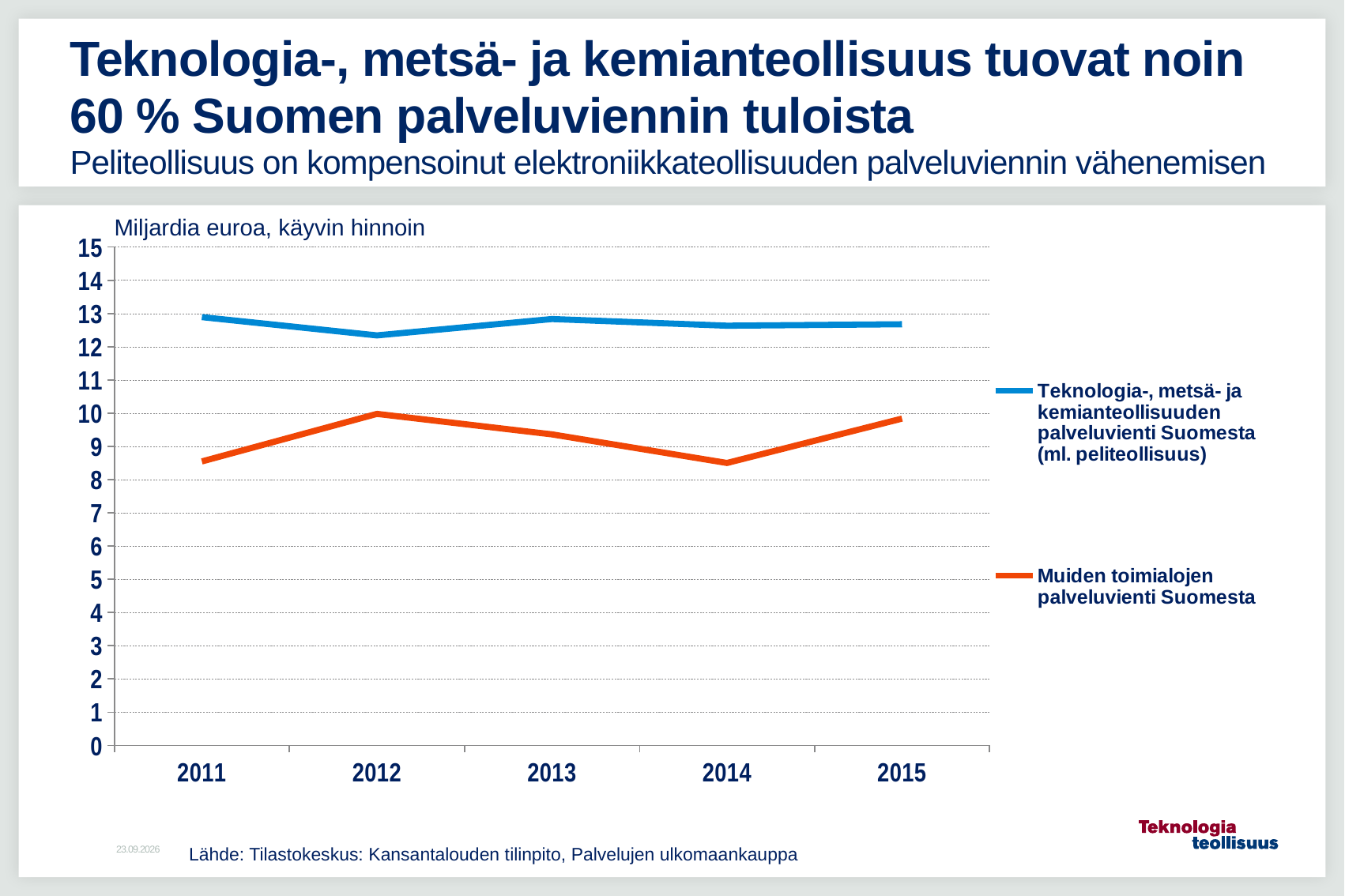
Is the value for Teknologia-, metsä- ja kemianteollisuuden palveluvienti Suomesta in 2012 greater or less than 12? greater Is the value for Muiden toimialojen palveluvienti Suomesta in 2015 greater or less than 9? greater Is the value for Muiden toimialojen palveluvienti Suomesta in 2011 greater or less than 9? less Does the value for Muiden toimialojen palveluvienti Suomesta rise or fall from 2013 to 2014? fall How many series does the legend list? 2 What unit is stated above the chart? Miljardia euroa, käyvin hinnoin What kind of chart is shown on the slide? line chart Which series has the higher value in 2013, Teknologia-, metsä- ja kemianteollisuuden palveluvienti Suomesta or Muiden toimialojen palveluvienti Suomesta? Teknologia-, metsä- ja kemianteollisuuden palveluvienti Suomesta In which year is the value for Teknologia-, metsä- ja kemianteollisuuden palveluvienti Suomesta lowest? 2012 How many years are shown on the x axis? 5 Does the value for Muiden toimialojen palveluvienti Suomesta rise or fall from 2011 to 2012? rise